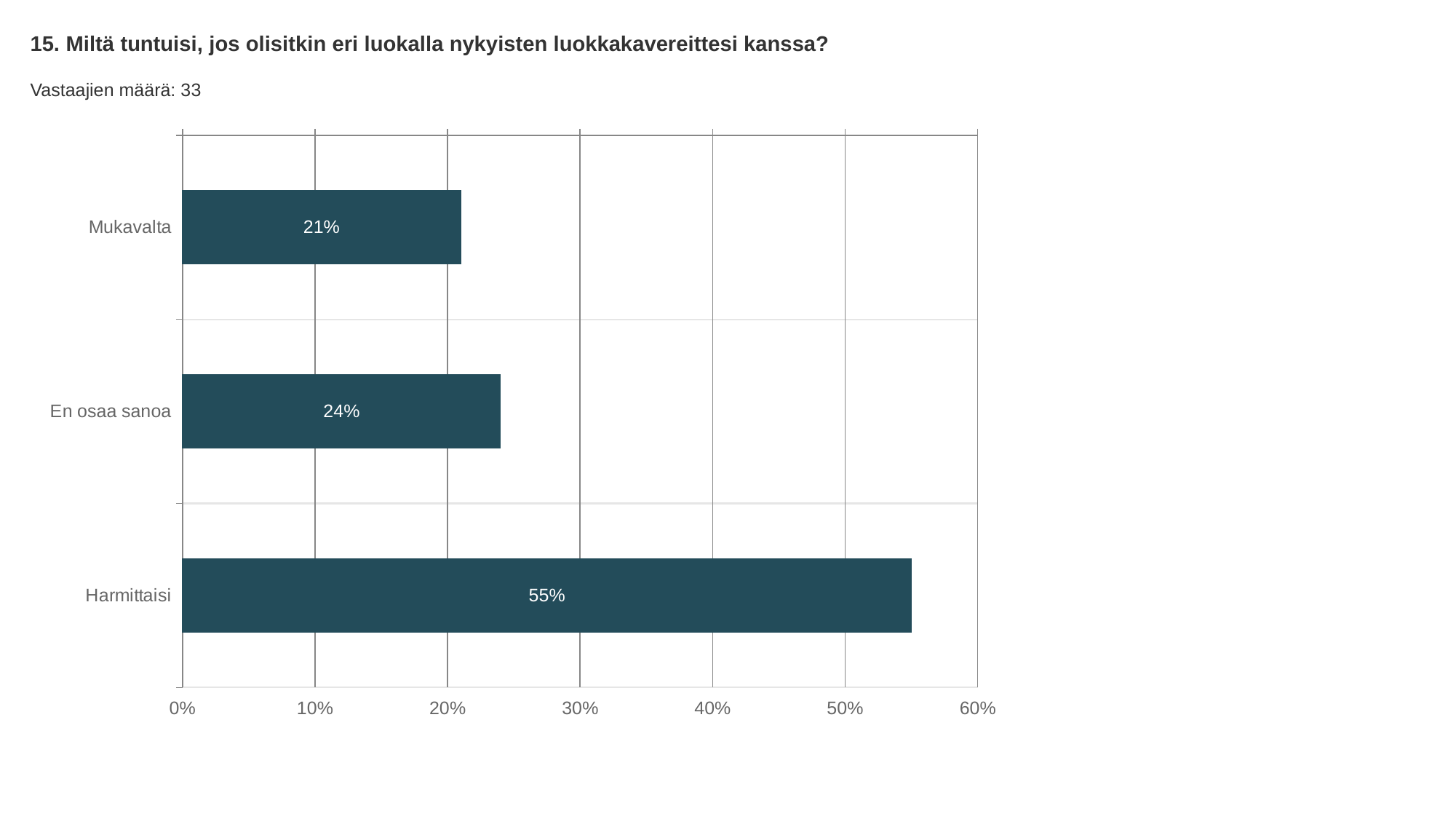
What is the difference between the values for En osaa sanoa and Mukavalta? 3% How many respondents (Vastaajien määrä) does the slide report? 33 Which category has the highest value? Harmittaisi Which category has the lowest value? Mukavalta Which is larger, the value for Harmittaisi or the value for Mukavalta? Harmittaisi What is the difference between the values for Harmittaisi and En osaa sanoa? 31% Is the value for Harmittaisi greater or less than 50%? greater What is the value for Mukavalta? 21% What is the value for En osaa sanoa? 24% How many categories are shown in the chart? 3 What kind of chart is shown on the slide? bar chart What is the value for Harmittaisi? 55%